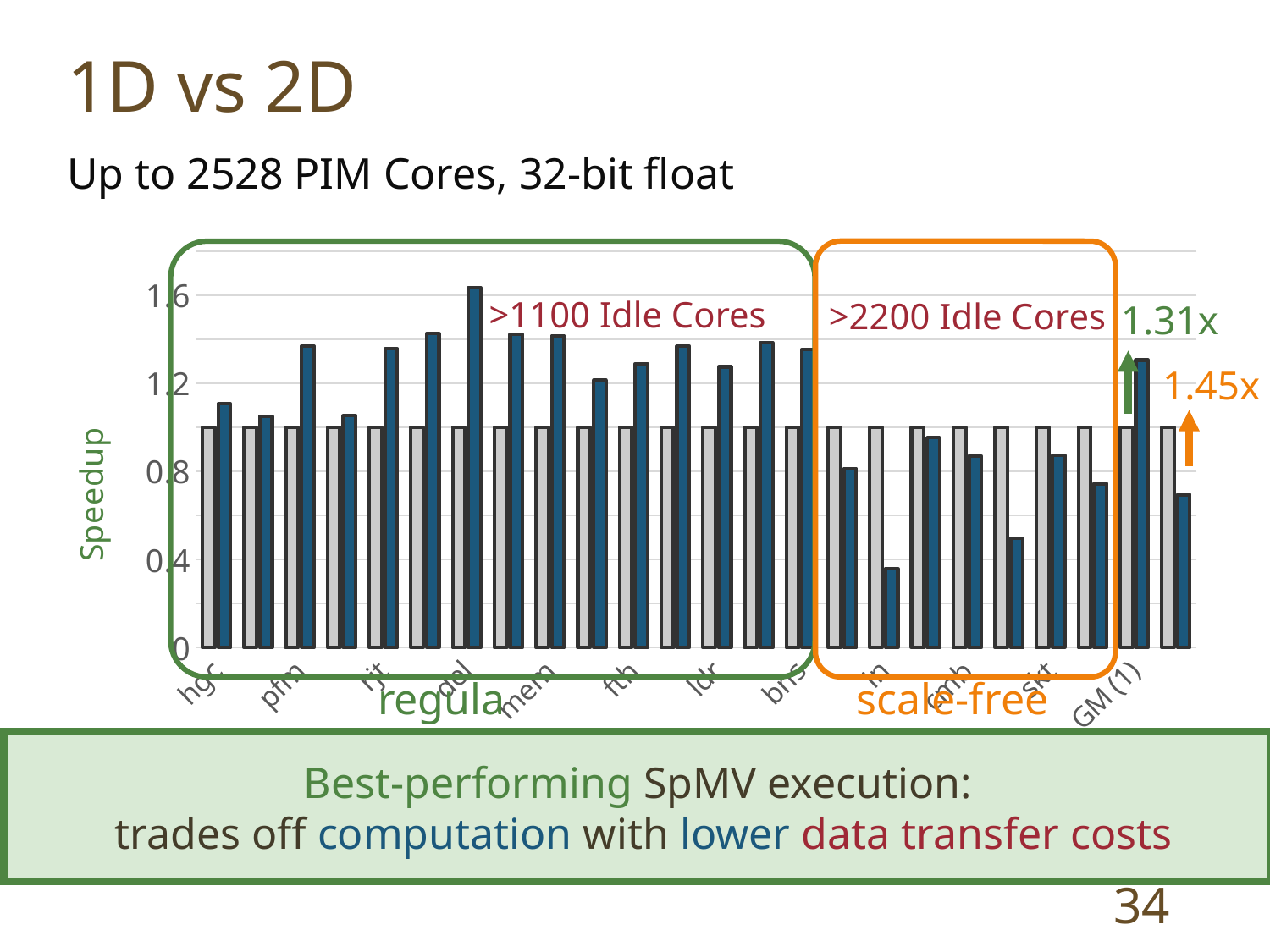
Which has the larger blue bar, del or hgc? del What kind of chart is shown on the slide? bar chart Which labelled matrix has the tallest blue bar in the chart? del What is the label of the y axis? Speedup What annotation is written inside the orange box over the scale-free group? >2200 Idle Cores What speedup value is annotated next to the orange arrow at the right of the chart? 1.45x Is the blue bar for bns greater or less than 1.2? greater Is the blue bar for pfm greater or less than 1.2? greater What speedup value is annotated next to the green arrow at the right of the chart? 1.31x Is the blue bar for hgc greater or less than 0.8? greater